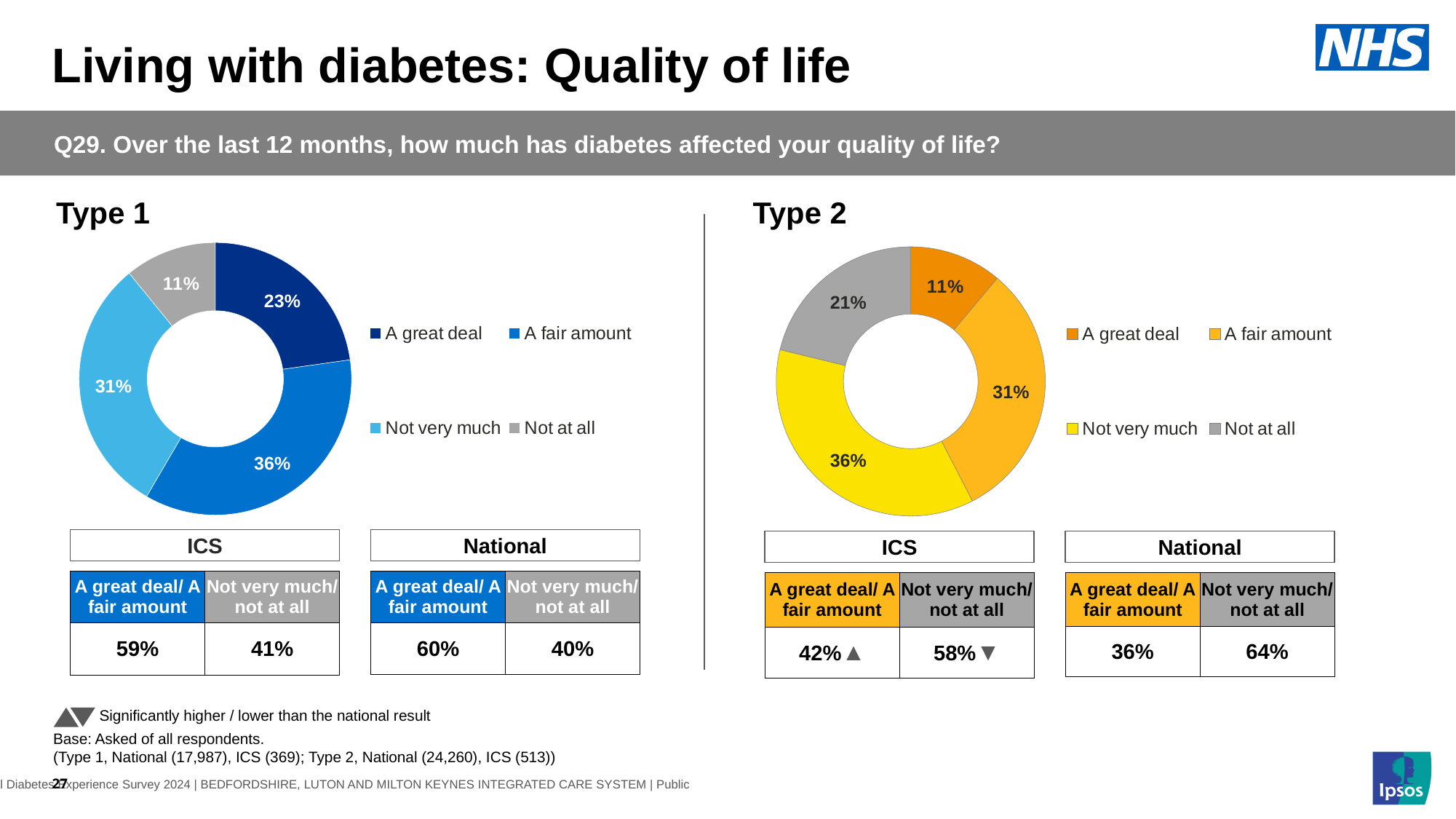
How many categories are shown in the Type 2 chart? 4 In the Type 2 chart, which category has the smallest share? A great deal Which is larger in the Type 1 chart: 'Not very much' or 'A great deal'? Not very much Which chart has the larger share for 'A great deal': Type 1 or Type 2? Type 1 In the Type 1 chart, what is the difference in percentage points between 'A fair amount' and 'Not at all'? 25 What kind of chart is used for the Type 1 data? Donut (pie) chart In the Type 2 chart, what is the difference in percentage points between 'Not very much' and 'A great deal'? 25 In the Type 2 chart, which category has the largest share? Not very much In the Type 1 chart, which category has the largest share? A fair amount In the Type 2 chart, what colour represents 'Not very much'? Yellow In the Type 1 chart, what percentage of respondents said diabetes affected their quality of life 'A great deal'? 23% In the Type 2 chart, what percentage of respondents said 'Not at all'? 21%